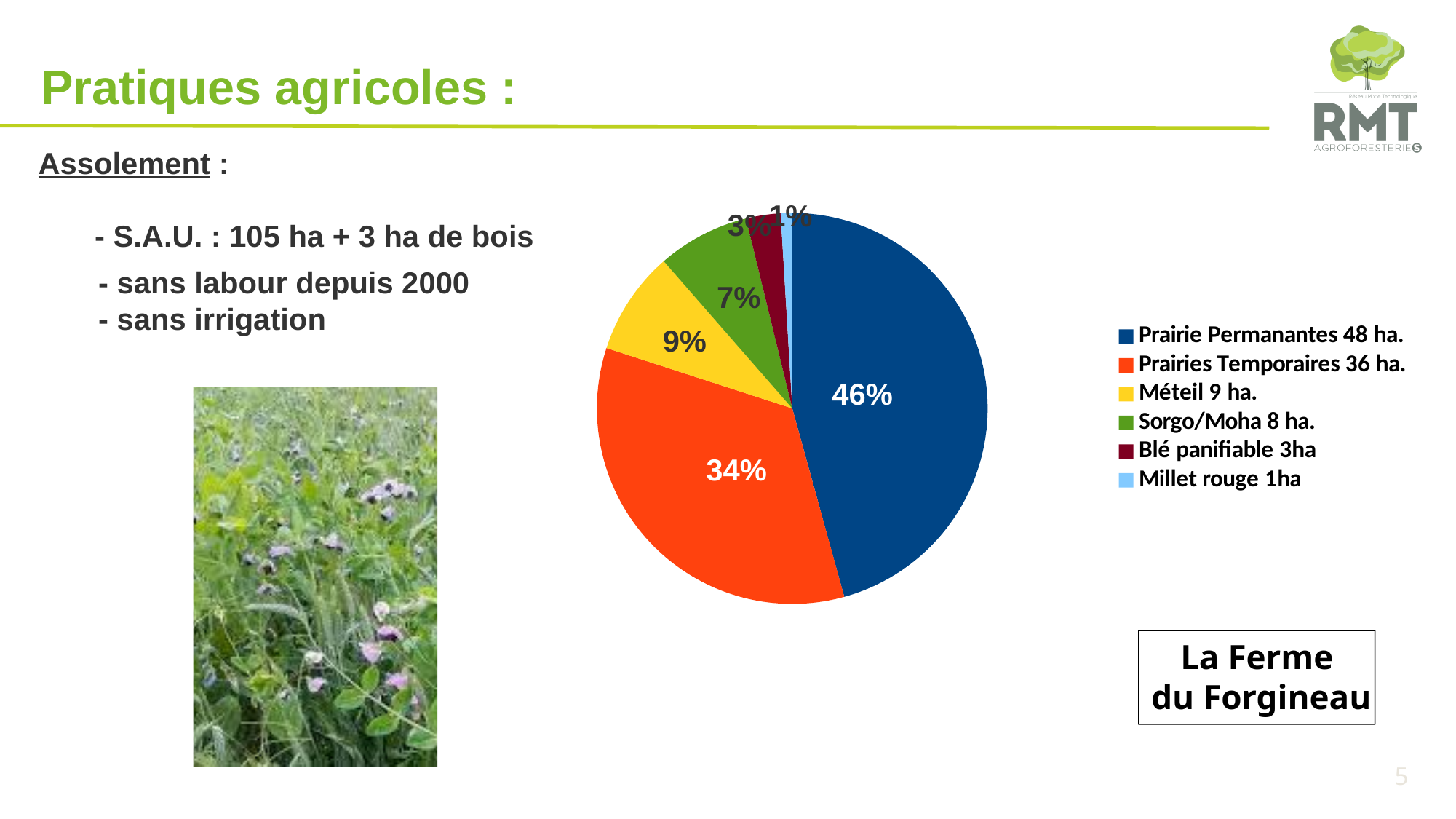
What kind of chart is shown on the slide? pie chart Which category has the smallest slice of the pie? Millet rouge Which slice is larger, Méteil or Sorgo/Moha? Méteil What percentage of the pie does Prairies Temporaires represent? 34% How many slices does the pie chart have? 6 Which category has the largest slice of the pie? Prairie Permanantes What colour is the Prairie Permanantes slice in the pie chart? dark blue According to the legend, how many hectares are Prairies Temporaires? 36 ha. What percentage of the pie does Sorgo/Moha represent? 7% What percentage of the pie does Méteil represent? 9% What is the difference in percentage points between the Prairie Permanantes slice and the Prairies Temporaires slice? 12